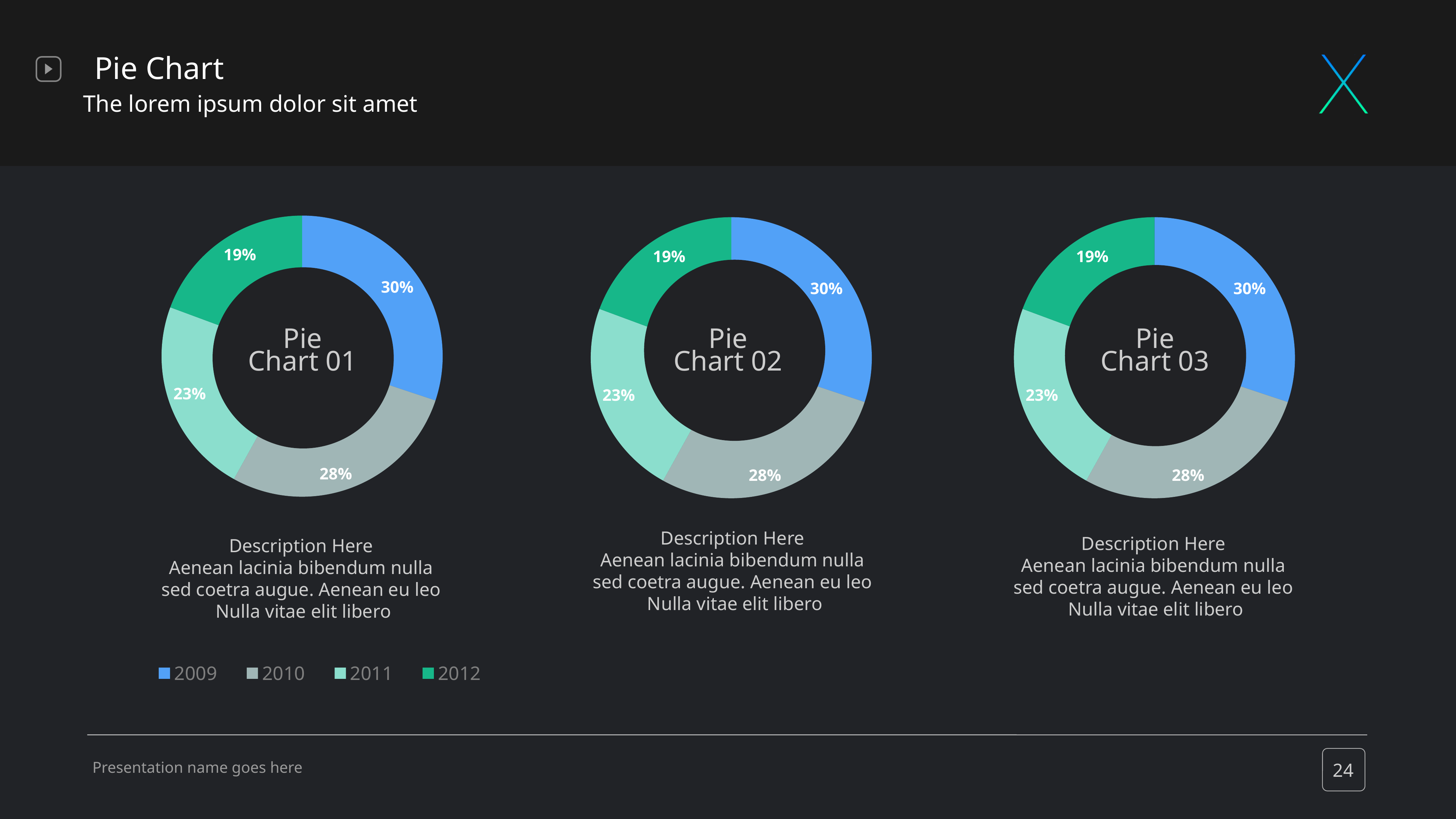
In Pie Chart 01, what share does 2009 have? 30% In Pie Chart 02, which is larger, the 2010 slice or the 2011 slice? 2010 In Pie Chart 03, what is the difference between the 2009 and 2010 slices? 2% How many slices does Pie Chart 03 have? 4 In Pie Chart 01, what is the difference between the 2011 and 2012 slices? 4% In Pie Chart 03, what share does 2012 have? 19% In Pie Chart 01, which year has the largest slice? 2009 In Pie Chart 02, which year has the smallest slice? 2012 What colour represents 2010 in the legend? Grey How many entries does the legend on the slide list? 4 What kind of chart is Pie Chart 01? Pie chart In Pie Chart 02, what share does 2011 have? 23%